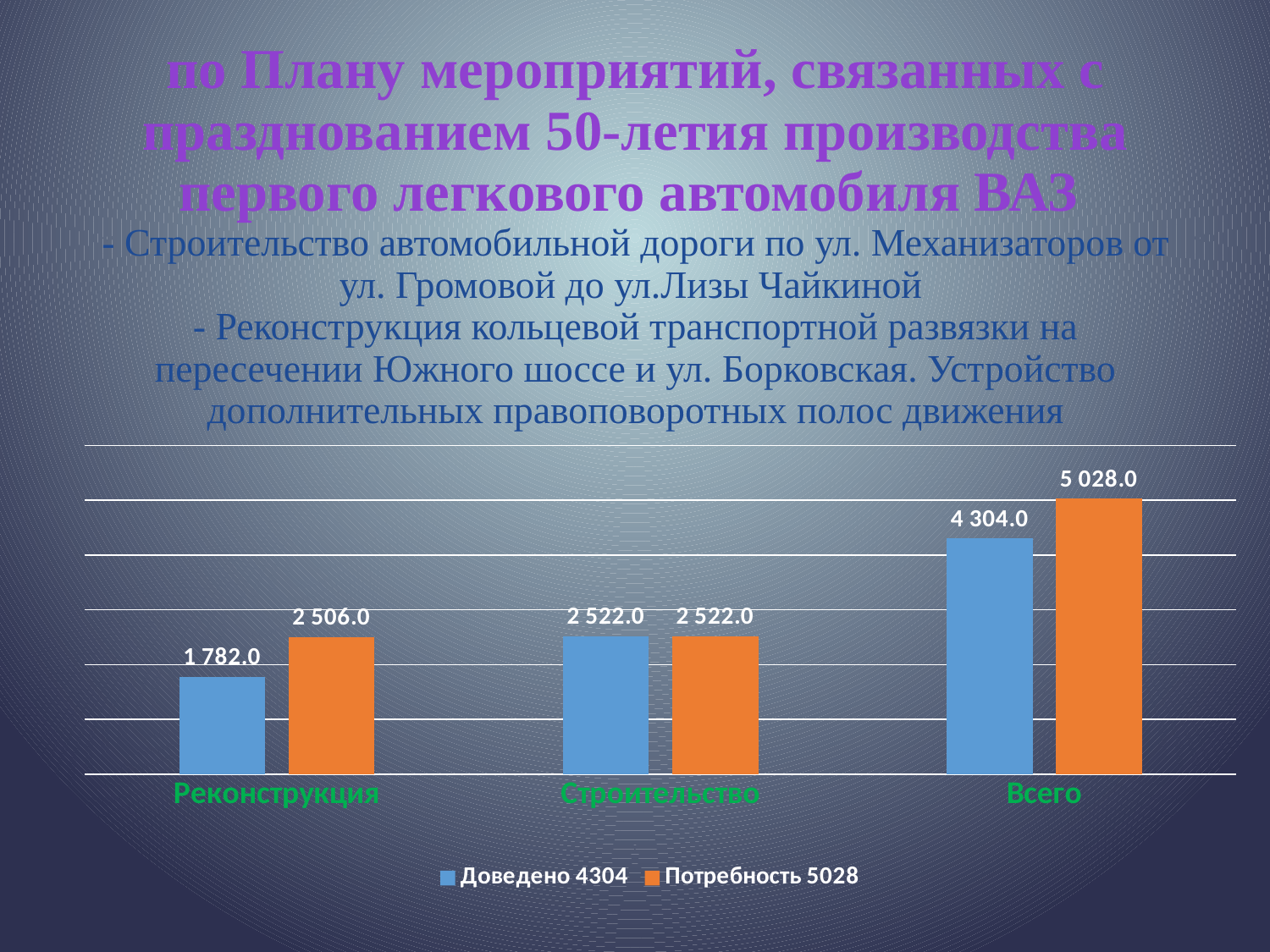
How many categories are shown on the x axis? 3 How many series does the legend list? 2 Which category has the lowest value for Потребность 5028? Реконструкция Which category has the highest value for Доведено 4304? Всего What is the value of Потребность 5028 for Реконструкция? 2 506.0 What is the value of Потребность 5028 for Всего? 5 028.0 What is the difference between Потребность 5028 and Доведено 4304 for Реконструкция? 724.0 What is the value of Доведено 4304 for Строительство? 2 522.0 What is the value of Доведено 4304 for Реконструкция? 1 782.0 For Реконструкция, which is larger: Доведено 4304 or Потребность 5028? Потребность 5028 What kind of chart is shown on the slide? Bar chart What is the difference between Потребность 5028 and Доведено 4304 for Всего? 724.0